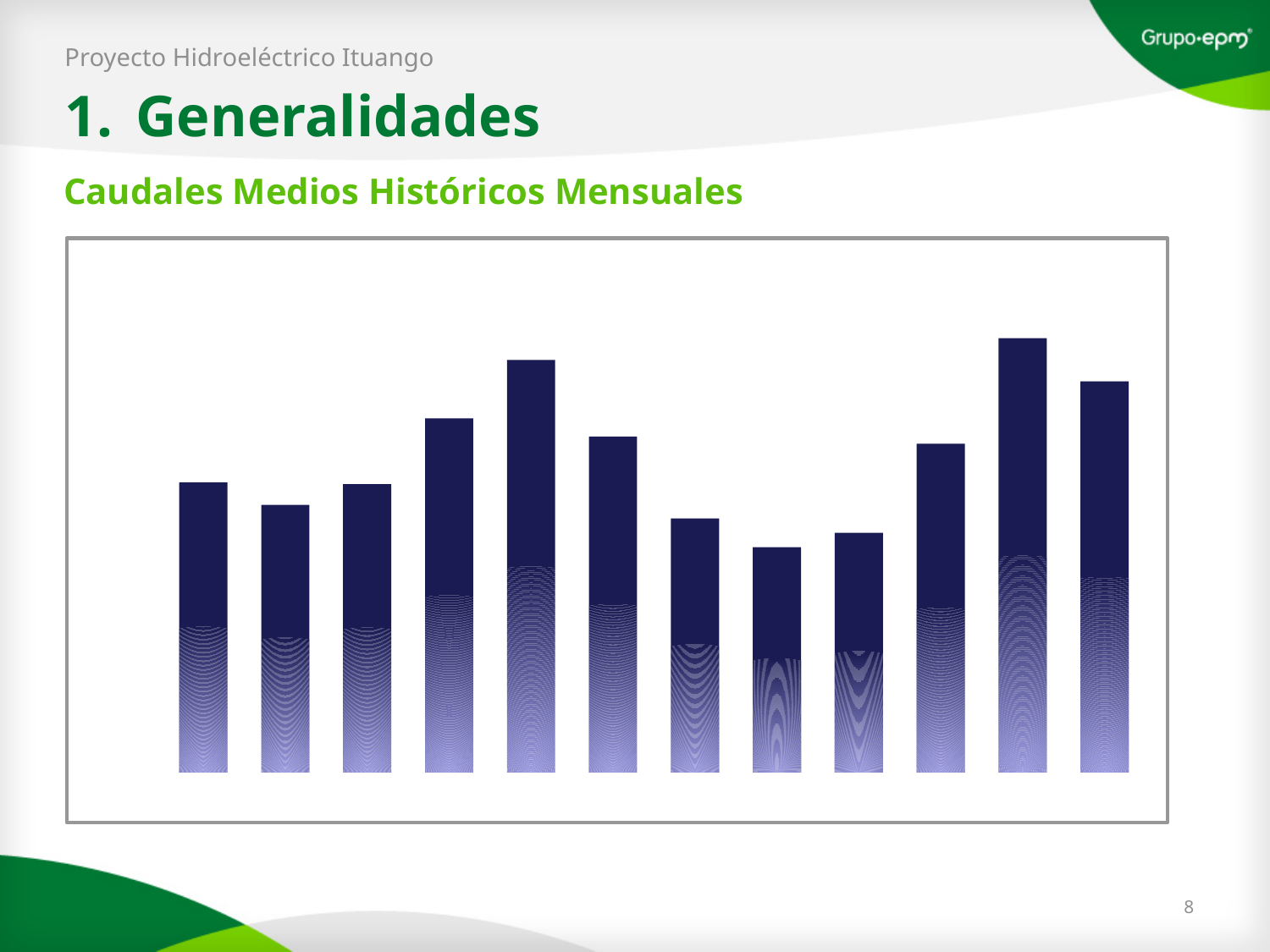
Which is taller, the 4th bar from the left or the 5th bar from the left? the 5th bar What is the title given above the chart? Caudales Medios Históricos Mensuales How many bars does the chart contain? 12 Do the bars rise or fall from the 8th bar to the 11th bar from the left? rise Which bar is the tallest in the chart, counting from the left? the 11th bar Which is taller, the 5th bar from the left or the 12th bar from the left? the 5th bar Do the bars rise or fall from the 5th bar to the 8th bar from the left? fall Which is taller, the 2nd bar from the left or the 8th bar from the left? the 2nd bar What kind of chart is shown on the slide? bar chart Does the chart display a legend? No Which bar is the shortest in the chart, counting from the left? the 8th bar